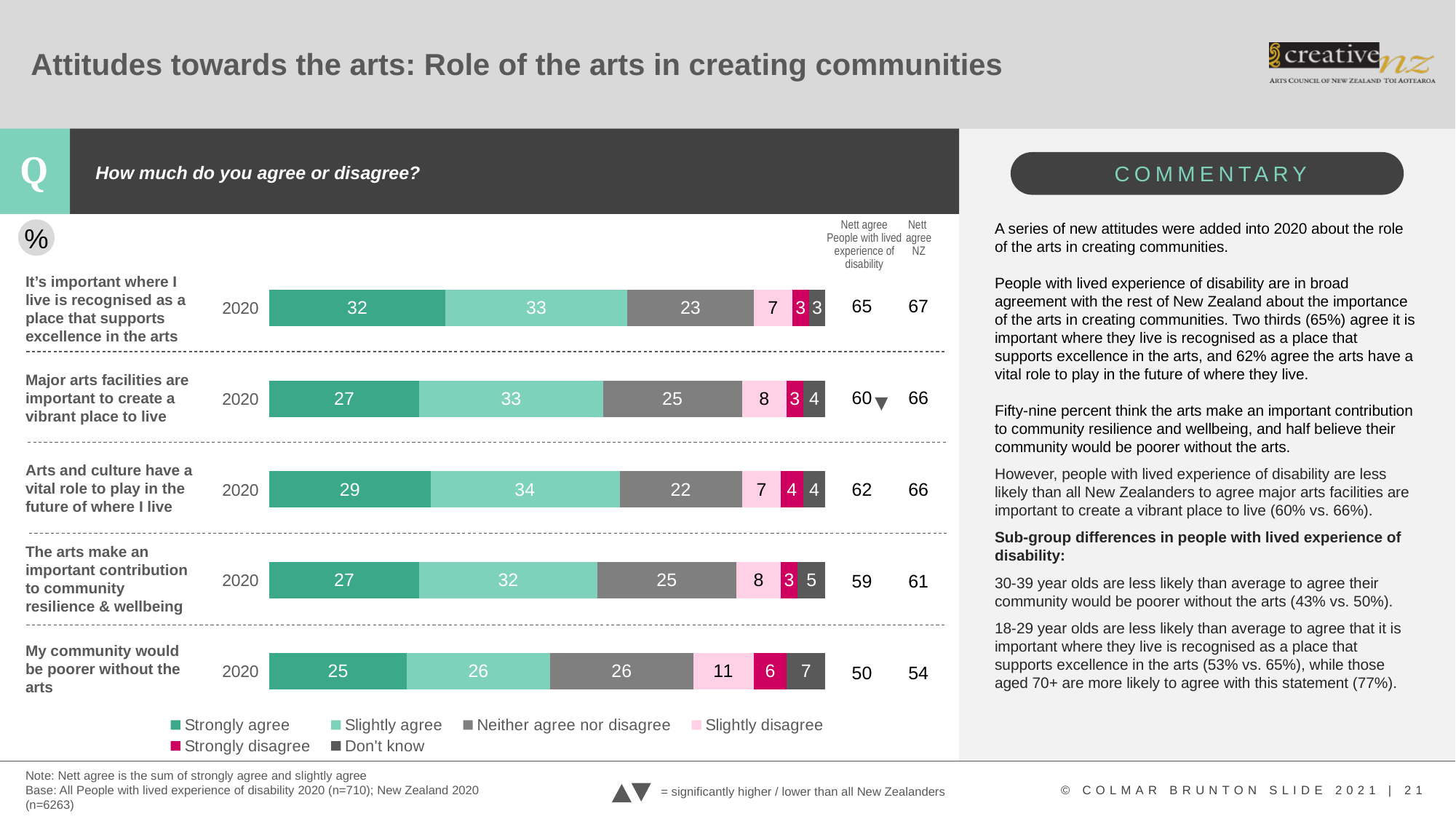
Which statement is marked with a downward arrow next to its Nett agree figure? Major arts facilities are important to create a vibrant place to live How many statements are shown in the chart? 5 Which statement has the lowest Nett agree figure for people with lived experience of disability? My community would be poorer without the arts Which has a larger 'Slightly agree' value: 'Arts and culture have a vital role to play in the future of where I live' or 'The arts make an important contribution to community resilience & wellbeing'? Arts and culture have a vital role to play in the future of where I live What is the 'Don't know' value for the statement 'The arts make an important contribution to community resilience & wellbeing'? 5 What is the Nett agree NZ figure for the statement 'Arts and culture have a vital role to play in the future of where I live'? 66 How many response categories does the legend list? 6 What type of chart is shown on the slide? Stacked bar chart For 'Major arts facilities are important to create a vibrant place to live', what is the difference between the Nett agree NZ figure and the Nett agree figure for people with lived experience of disability? 6 What is the 'Neither agree nor disagree' value for the statement 'Major arts facilities are important to create a vibrant place to live'? 25 What percentage of people with lived experience of disability strongly agree that their community would be poorer without the arts? 25 Which statement has the highest 'Strongly agree' percentage? It's important where I live is recognised as a place that supports excellence in the arts